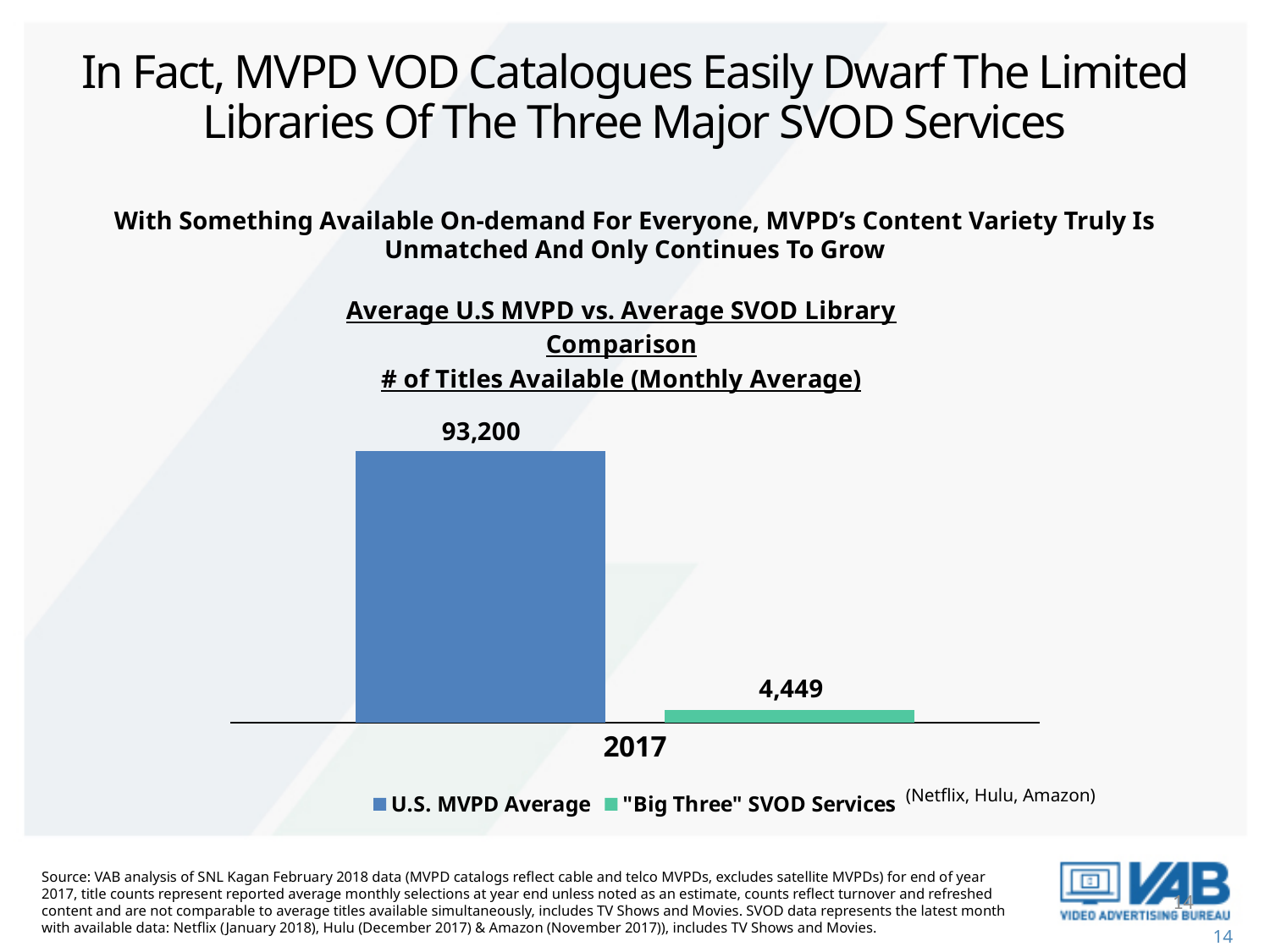
How many categories are shown on the x axis? 1 What kind of chart is shown on the slide? bar chart How many series does the legend list? 2 Is the value for U.S. MVPD Average larger or smaller than the value for "Big Three" SVOD Services? larger What year is shown on the x axis of the chart? 2017 Which three services make up the "Big Three" SVOD Services, as noted next to the legend? Netflix, Hulu, Amazon Which series has the higher value in 2017? U.S. MVPD Average What is the value for "Big Three" SVOD Services in 2017? 4,449 Which series has the lower value in 2017? "Big Three" SVOD Services What is the value for U.S. MVPD Average in 2017? 93,200 What is the difference between the U.S. MVPD Average and the "Big Three" SVOD Services values? 88,751